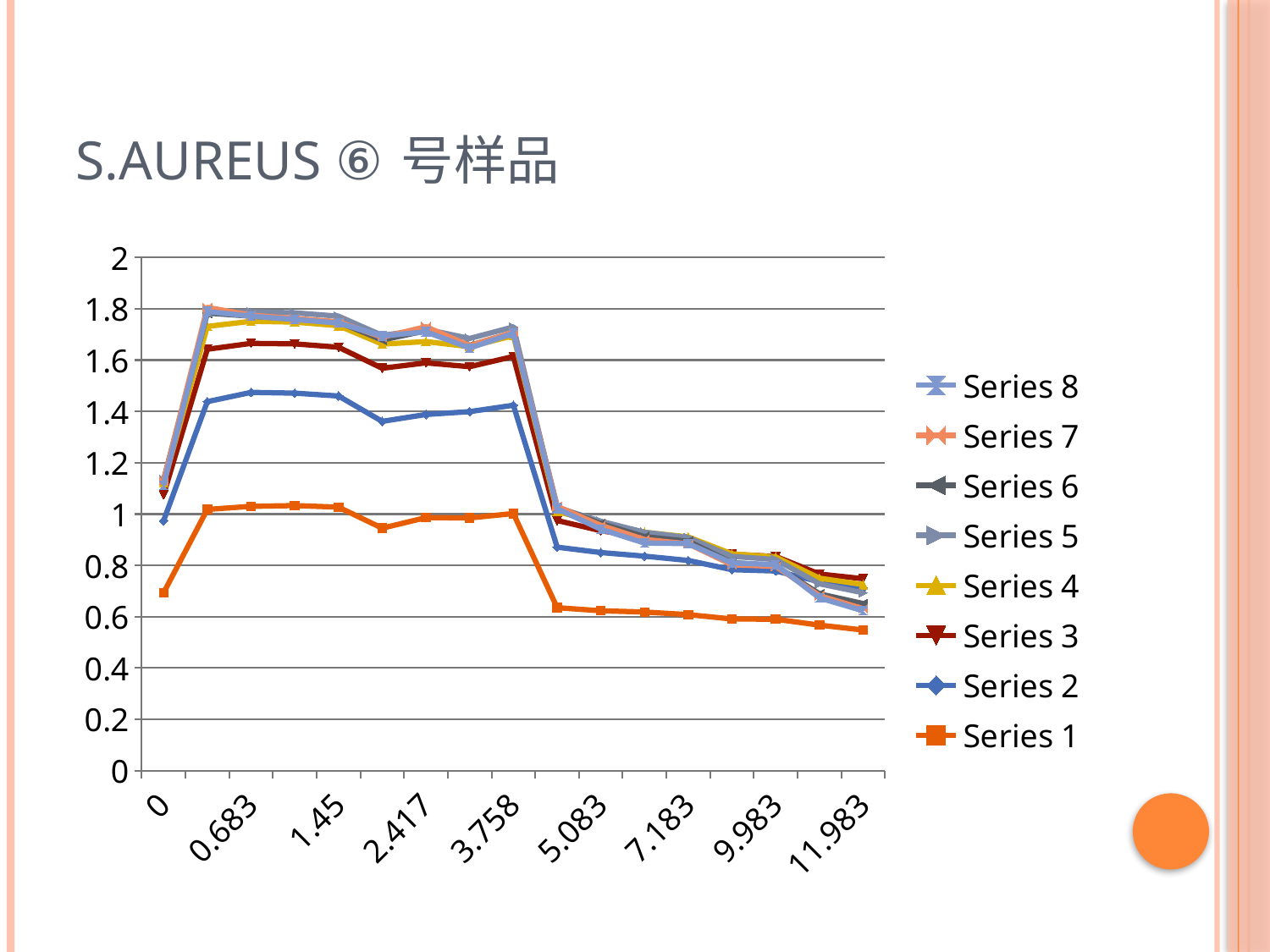
Is the value for Series 1 at x = 0 greater or less than 0.8? less What is the title of the slide? S.AUREUS ⑥ 号样品 Is the value for Series 2 at x = 1.45 greater or less than 1.4? greater Is the value for Series 8 at x = 0.683 greater or less than 1.6? greater Which series is drawn in orange with square markers? Series 1 Which series has the lowest values across the whole x axis? Series 1 Do the values of Series 1 rise or fall from x = 5.083 to x = 11.983? fall What kind of chart is shown on the slide? line chart At x = 0, which is larger: Series 1 or Series 2? Series 2 How many series does the legend list? 8